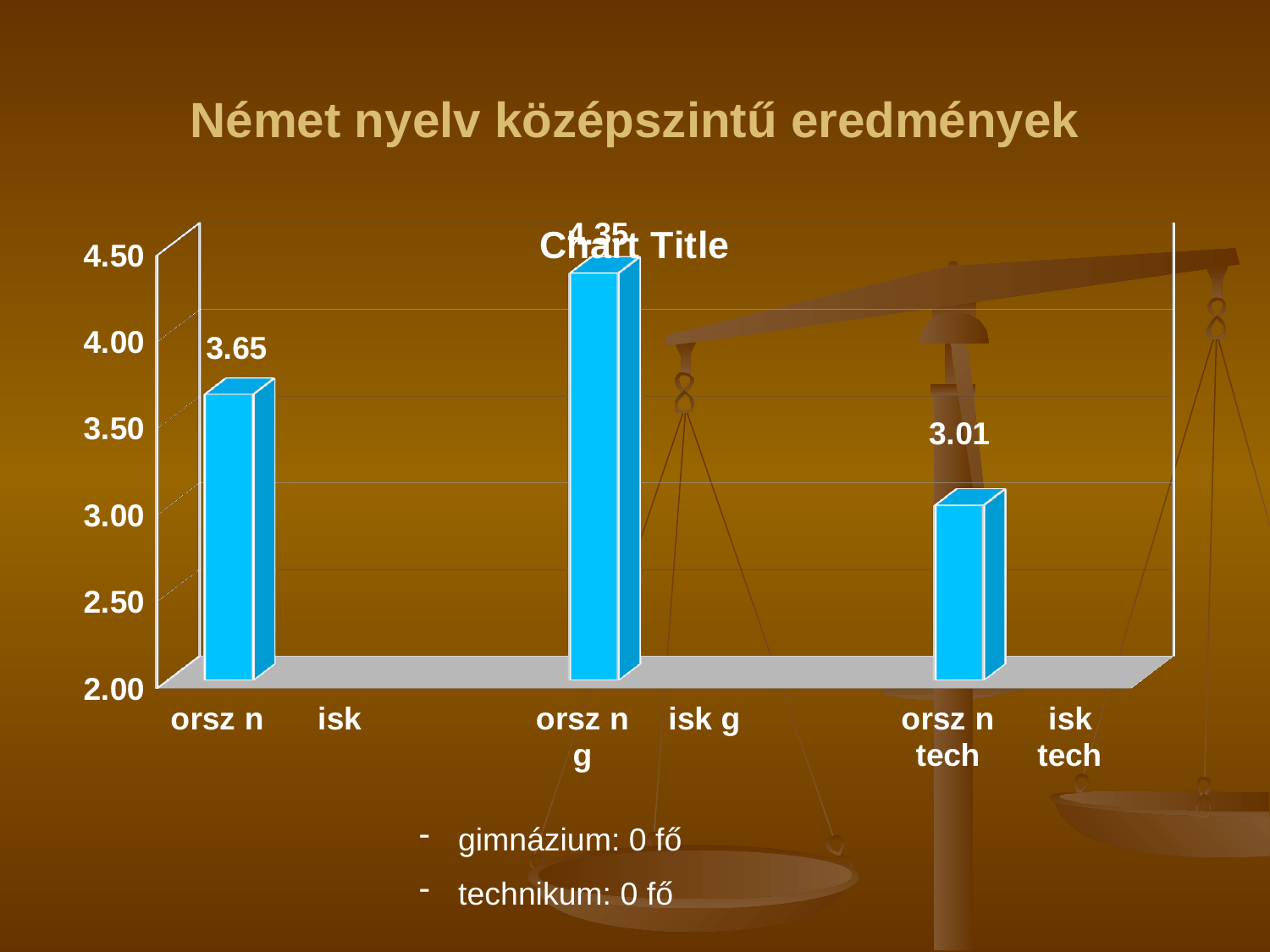
Which of the plotted bars is the lowest? orsz n tech What kind of chart is shown on the slide? bar chart How many category labels are shown on the x axis? 6 Which category has the highest bar? orsz n g Which is larger, the value for "orsz n" or the value for "orsz n tech"? orsz n What is the value for "orsz n tech"? 3.01 What is the difference between the values for "orsz n" and "orsz n tech"? 0.64 Is the value for "orsz n tech" greater or less than 3.50? less How many bars are plotted on the chart? 3 What is the value for "orsz n g"? 4.35 What is the value for "orsz n"? 3.65 What is the difference between the values for "orsz n g" and "orsz n"? 0.70